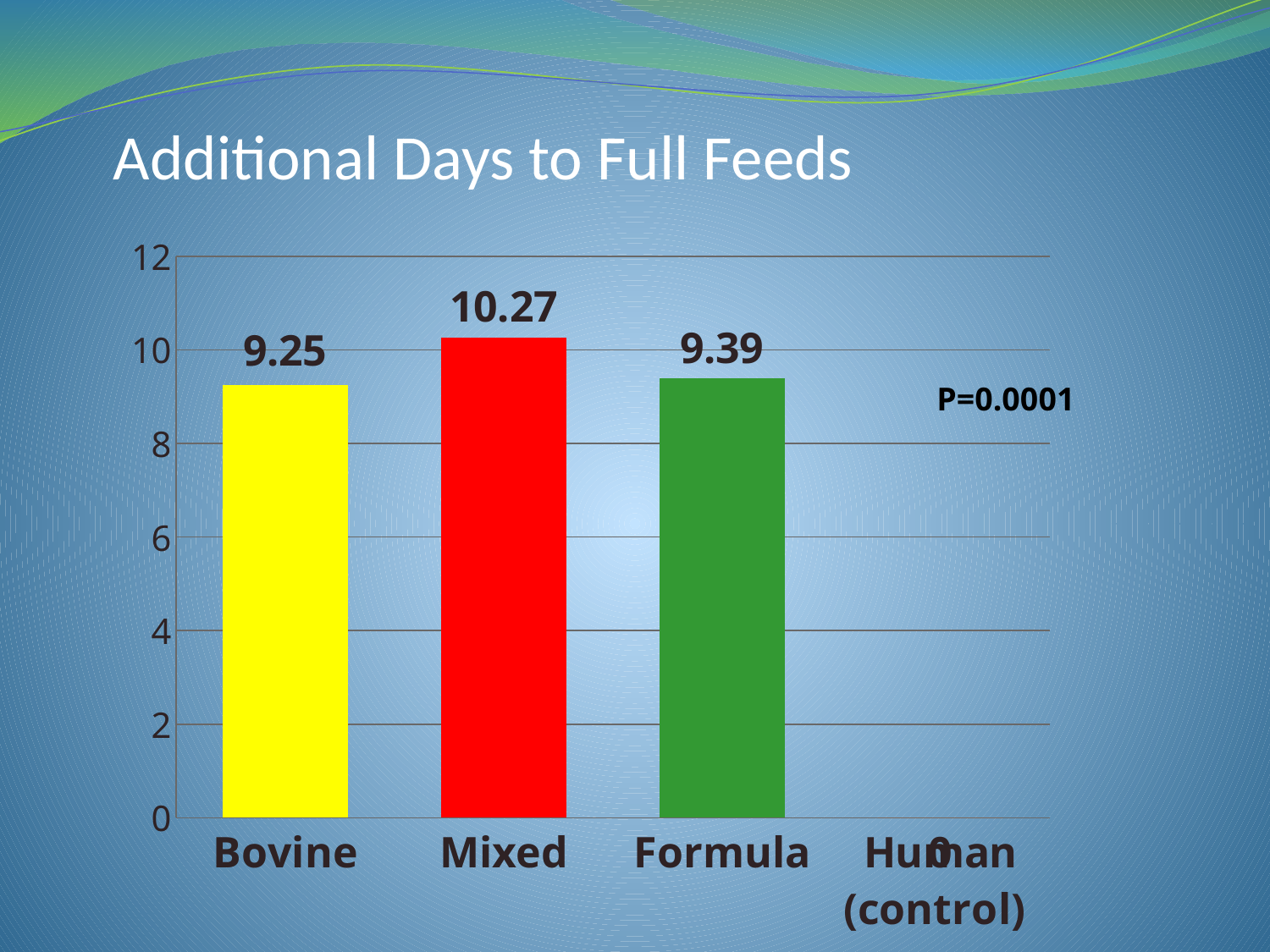
What is the value for Human (control)? 0 What is the value for Mixed? 10.27 How many categories are shown on the x axis? 4 What is the difference between the values for Mixed and Formula? 0.88 What is the value for Bovine? 9.25 What is the title of the chart? Additional Days to Full Feeds What kind of chart is shown on the slide? Bar chart What is the difference between the values for Mixed and Bovine? 1.02 Which category has the highest value? Mixed Which category has the lowest value? Human (control) What is the value for Formula? 9.39 Which is larger, the value for Formula or the value for Bovine? Formula